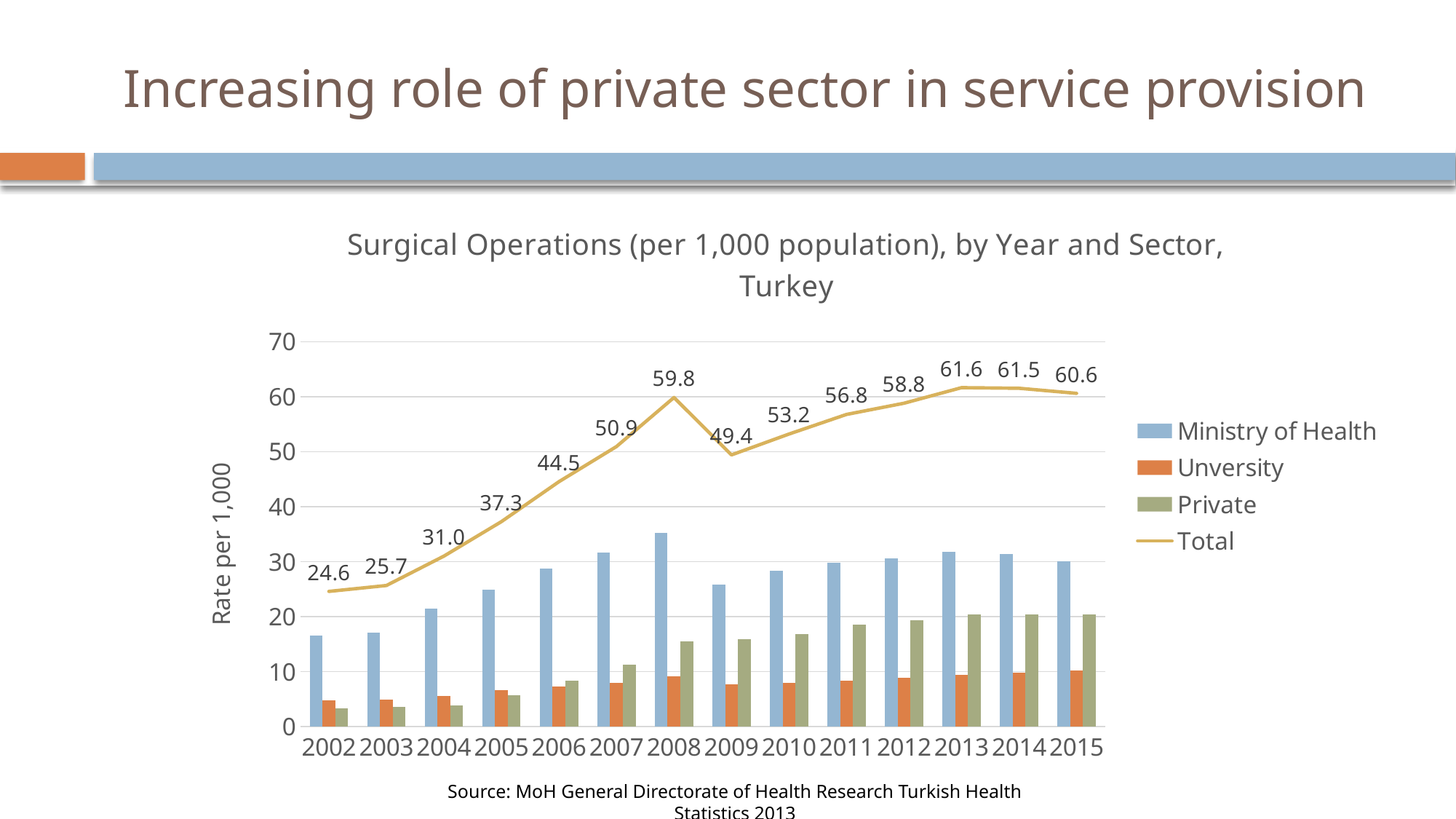
How many years are shown on the x axis? 14 What is the Total value for 2013? 61.6 What is the Total value for 2008? 59.8 In which year is the Total value highest? 2013 How many series does the legend list? 4 Which year has a higher Total value, 2009 or 2010? 2010 Is the Ministry of Health value for 2008 greater or less than 30? greater By how much did the Total value fall from 2008 to 2009? 10.4 In which year is the Total value lowest? 2002 What is the Total value for 2002? 24.6 Does the Total value rise or fall from 2002 to 2008? rise Is the Private value for 2002 greater or less than 10? less